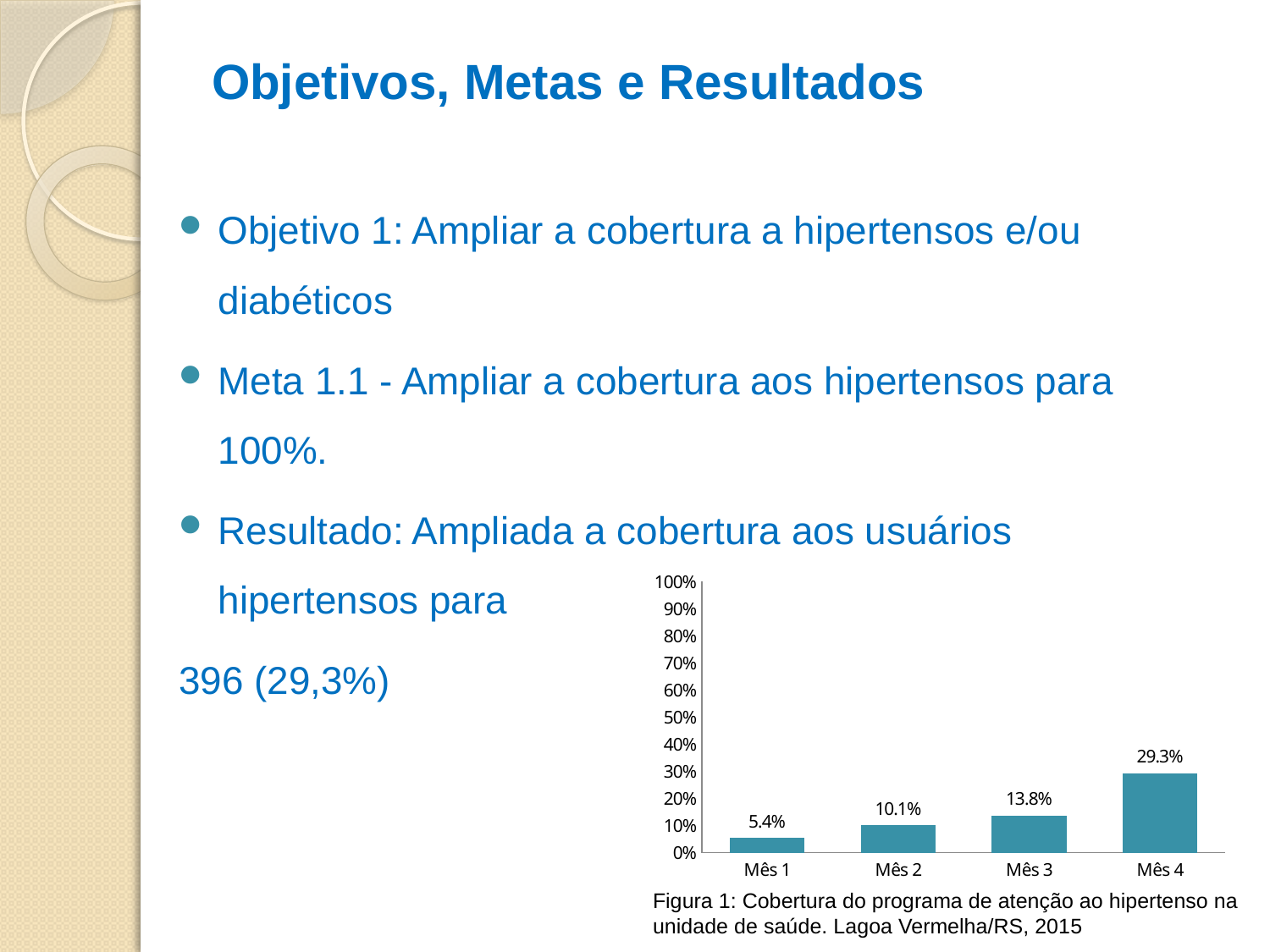
What kind of chart is shown on the slide? bar chart Do the values rise or fall from Mês 1 to Mês 4? rise What is the value for Mês 4? 29.3% What is the difference between the values for Mês 4 and Mês 3? 15.5% What is the difference between the values for Mês 2 and Mês 1? 4.7% Which is larger, the value for Mês 2 or the value for Mês 3? Mês 3 How many months are shown on the x axis of the chart? 4 Which month has the highest coverage value? Mês 4 What is the value for Mês 1? 5.4% Which month has the lowest coverage value? Mês 1 What is the value for Mês 3? 13.8% Is the value for Mês 4 greater or less than 20%? greater